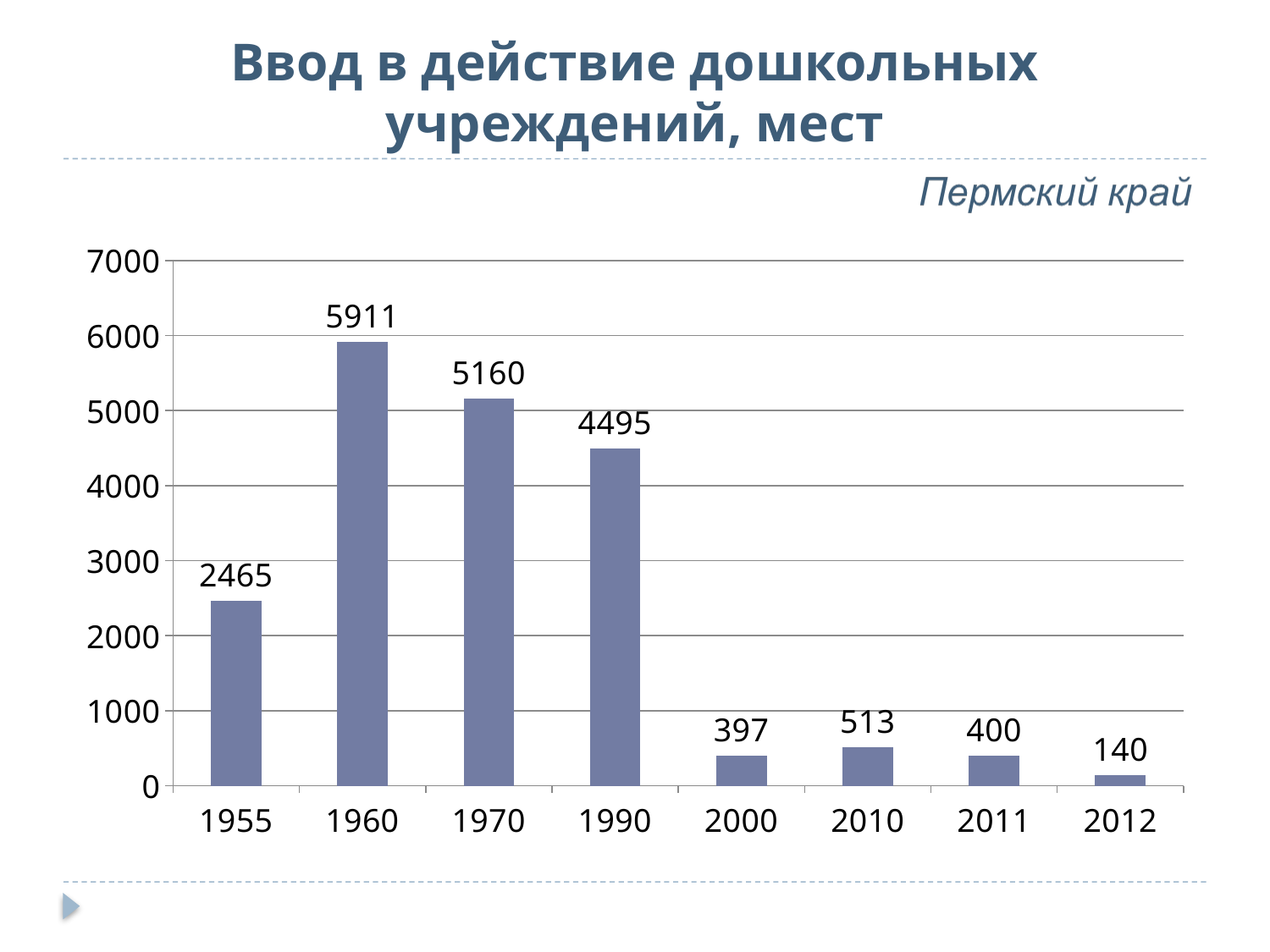
What is the value for 2012? 140 What is the value for 1960? 5911 How many years are shown on the x axis? 8 Which year has the highest value? 1960 What is the difference between the values for 1960 and 1970? 751 Which year has the lowest value? 2012 Is the value for 1990 greater or less than 4000? greater What is the difference between the values for 2010 and 2011? 113 What region is named in the subtitle above the chart? Пермский край Which is larger, the value for 1955 or the value for 2000? 1955 What kind of chart is shown on the slide? bar chart What is the value for 1990? 4495